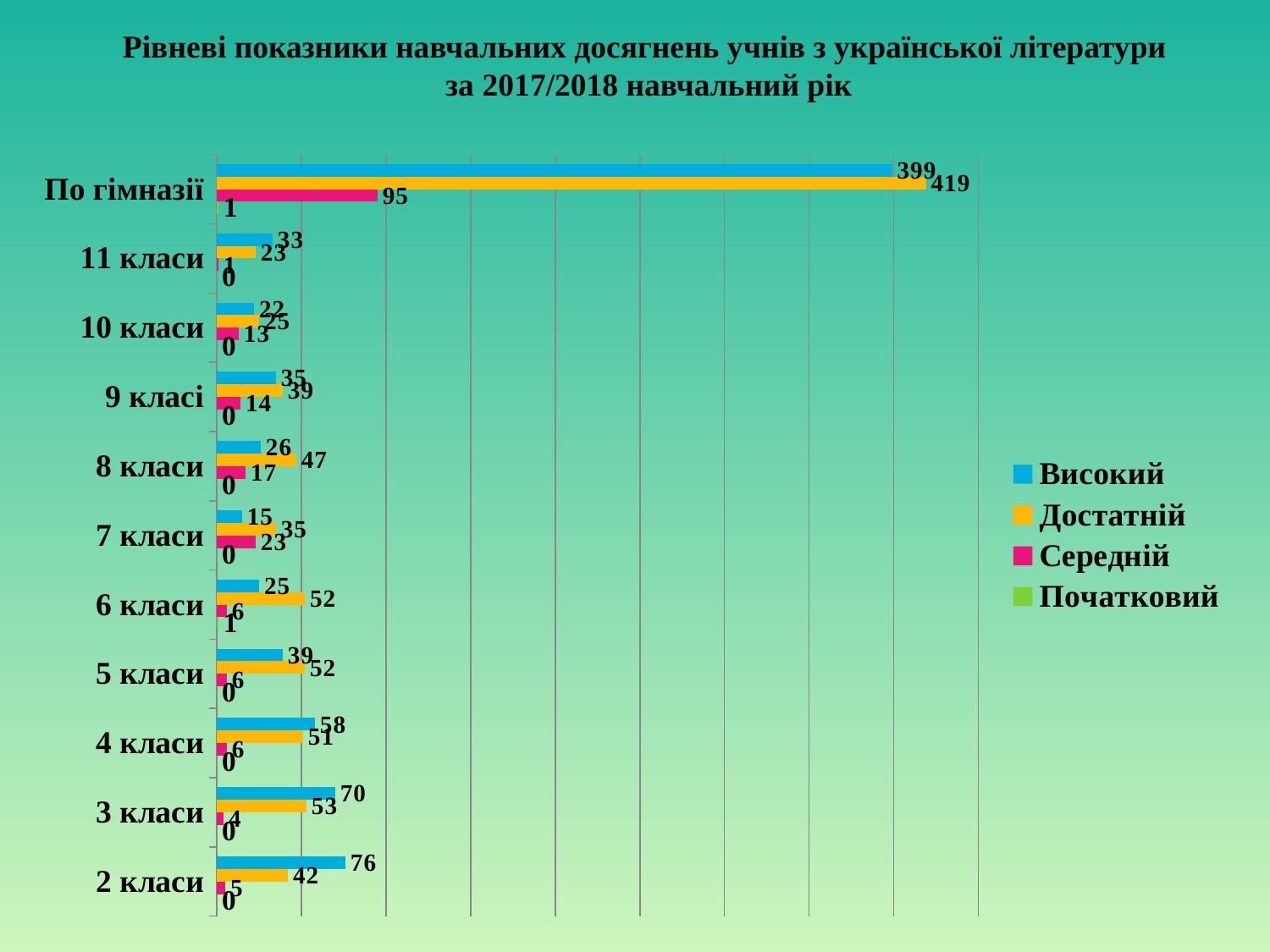
For По гімназії, what is the difference between the Достатній value and the Високий value? 20 Among the individual class groups (excluding По гімназії), which has the lowest Високий value? 7 класи Among the individual class groups (excluding По гімназії), which has the highest Високий value? 2 класи What is the value of the Достатній series for 8 класи? 47 What is the value of the Початковий series for 6 класи? 1 How many categories are shown on the vertical axis of the chart? 11 What is the value of the Високий series for 2 класи? 76 What type of chart is shown on the slide? Bar chart Among the individual class groups (excluding По гімназії), which has the highest Середній value? 7 класи How many series does the legend list? 4 What is the value of the Середній series for По гімназії? 95 For 4 класи, which is larger: the Високий value or the Достатній value? Високий